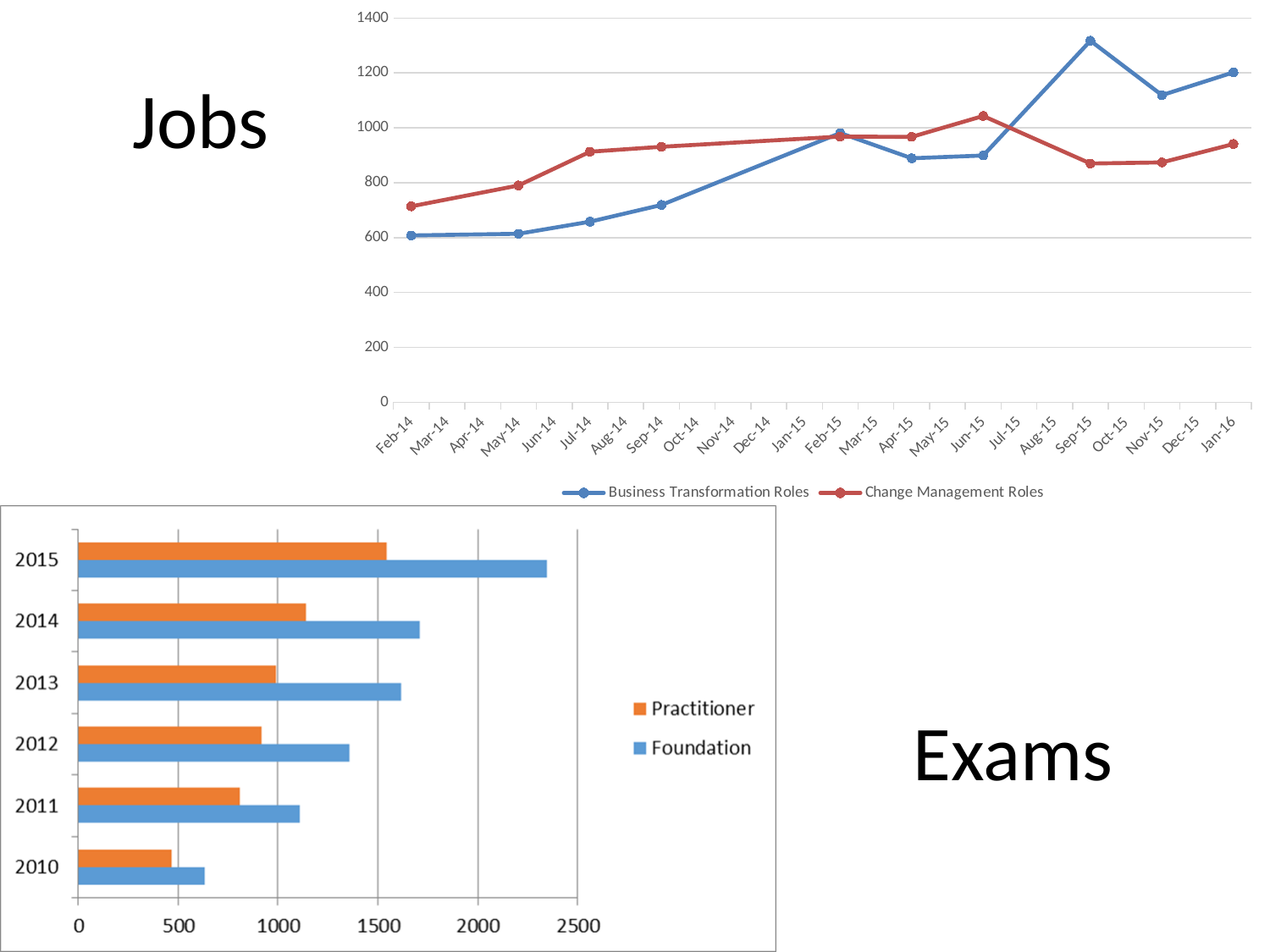
In the Exams chart, is the Foundation value for 2014 greater or less than 1500? greater In the Jobs chart, is the value for Business Transformation Roles at Sep-15 greater or less than 1200? greater In the Jobs chart, at which month does the Change Management Roles series reach its highest value? Jun-15 In the Jobs chart, which series has the higher value at Jan-16, Business Transformation Roles or Change Management Roles? Business Transformation Roles In the Exams chart, which year has the highest Foundation value? 2015 In the Jobs chart, which series has the higher value at Jul-14, Business Transformation Roles or Change Management Roles? Change Management Roles In the Exams chart, how many years are shown? 6 In the Jobs chart, at which month does the Business Transformation Roles series reach its highest value? Sep-15 What kind of chart is the Jobs chart? line chart In the Jobs chart, is the value for Business Transformation Roles at Feb-14 greater or less than 800? less What kind of chart is the Exams chart? bar chart In the Jobs chart, how many series does the legend list? 2